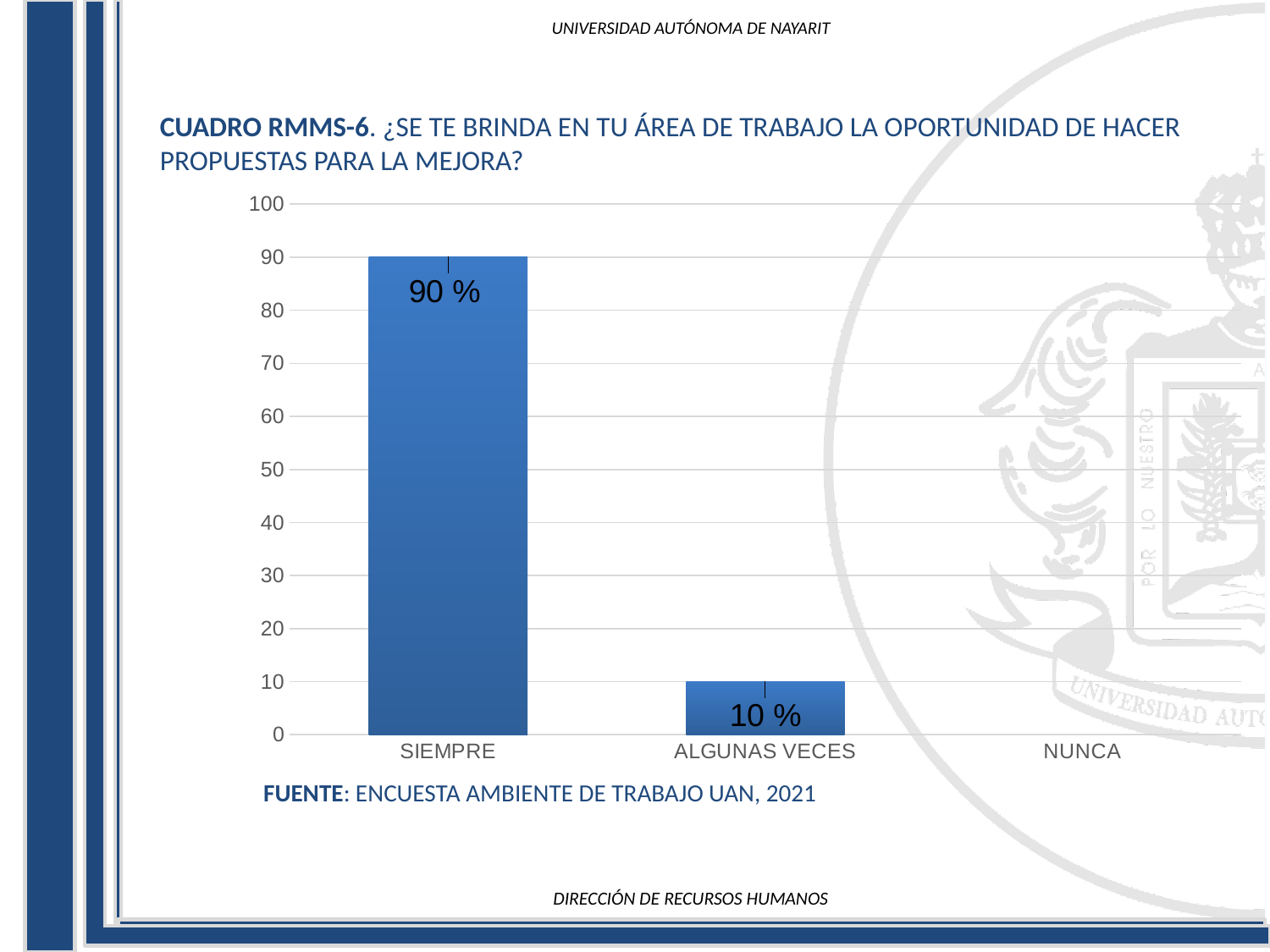
How many categories are shown on the x axis? 3 Which is larger, the value for SIEMPRE or the value for ALGUNAS VECES? SIEMPRE What is the value for SIEMPRE? 90 % What source is cited below the chart? ENCUESTA AMBIENTE DE TRABAJO UAN, 2021 Which category has the highest value? SIEMPRE What is the difference between the values for SIEMPRE and ALGUNAS VECES? 80 % What kind of chart is shown on the slide? bar chart Is the value for SIEMPRE greater or less than 50? greater What is the value for ALGUNAS VECES? 10 % What is the label of the third category on the x axis? NUNCA Is the value for ALGUNAS VECES greater or less than 20? less Do the values rise or fall from left to right along the x axis? fall